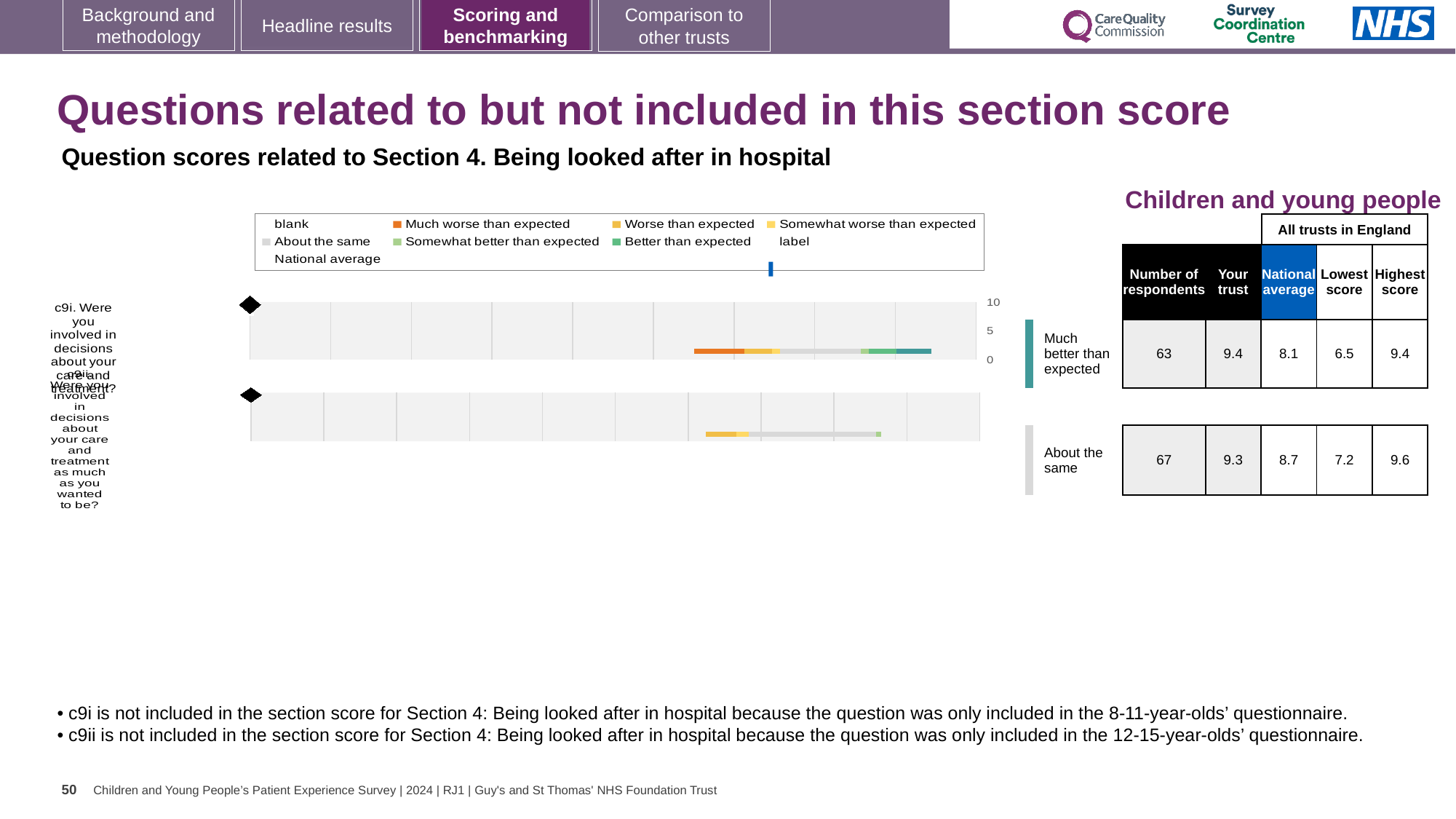
How many entries does the chart legend list? 9 Which benchmark category is shown next to the bar for question c9i? Much better than expected In the table beside the chart, what is the difference between the trust score and the national average for question c9i? 1.3 What is the highest value shown on the chart's axis? 10 How many question bars are plotted in the chart? 2 In the table beside the chart, what is the 'Your trust' score for question c9ii? 9.3 Which benchmark category is shown next to the bar for question c9ii? About the same In the table beside the chart, what is the national average for question c9i? 8.1 What kind of chart is shown on the slide? bar chart In the table beside the chart, what is the 'Your trust' score for question c9i? 9.4 In the table beside the chart, how many respondents answered question c9ii? 67 In the table beside the chart, which question has the higher national average, c9i or c9ii? c9ii